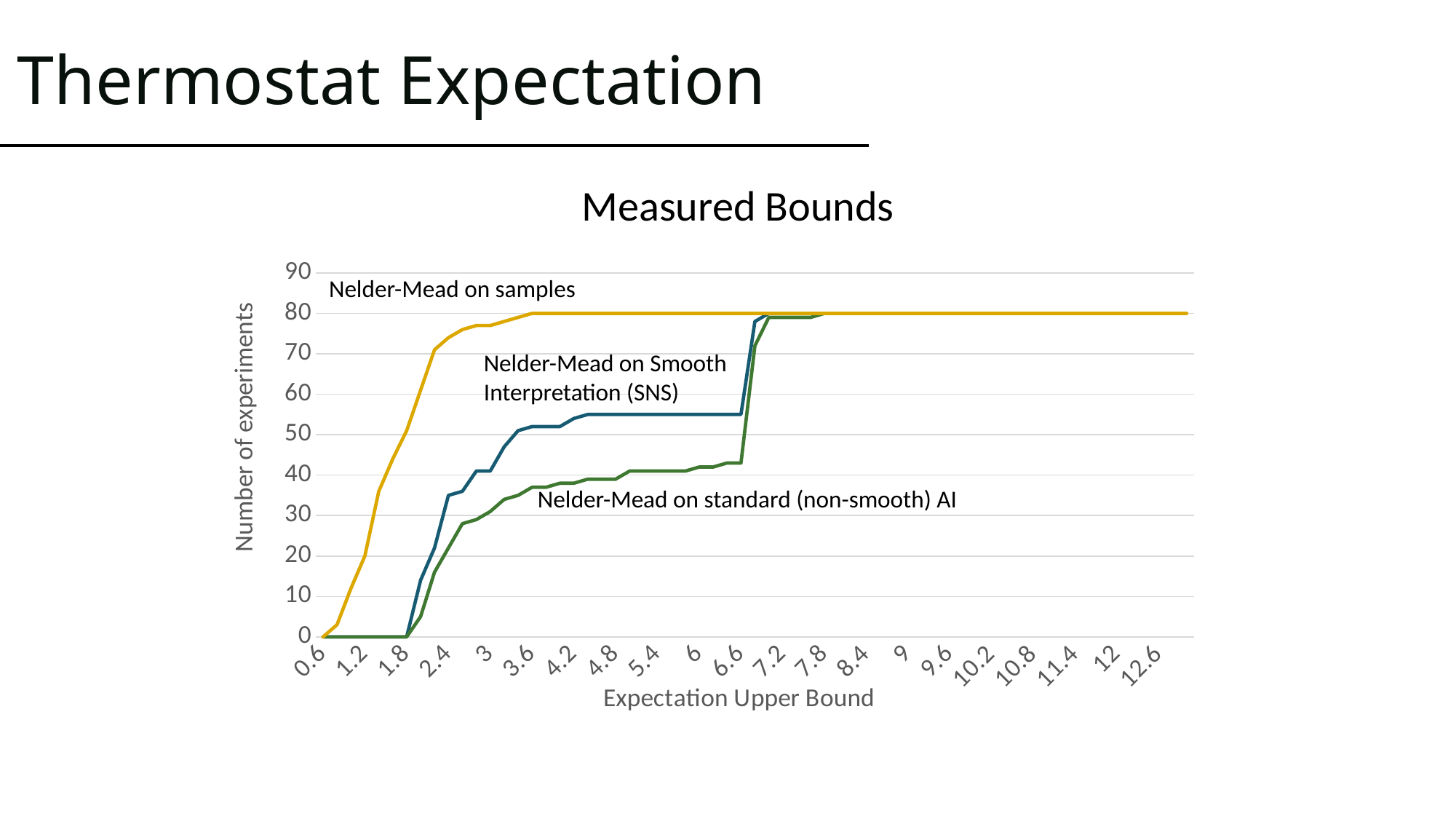
What value does the 'Nelder-Mead on samples' line reach at an expectation upper bound of 12.6? 80 How many lines (series) are plotted on the chart? 3 What kind of chart is shown on the slide? line chart What is the value of the 'Nelder-Mead on standard (non-smooth) AI' line at an expectation upper bound of 0.6? 0 Is the value of the 'Nelder-Mead on Smooth Interpretation (SNS)' line at an expectation upper bound of 4.8 greater or less than 50? greater Is the value of the 'Nelder-Mead on standard (non-smooth) AI' line at an expectation upper bound of 6.6 greater or less than 50? less What is the label of the vertical axis of the chart? Number of experiments At an expectation upper bound of 3, which line is higher: 'Nelder-Mead on Smooth Interpretation (SNS)' or 'Nelder-Mead on standard (non-smooth) AI'? Nelder-Mead on Smooth Interpretation (SNS) Is the value of the 'Nelder-Mead on samples' line at an expectation upper bound of 1.2 greater or less than 30? less What is the title of the chart? Measured Bounds Do the values of the 'Nelder-Mead on samples' line rise or fall as the expectation upper bound increases from 0.6 to 3.6? rise